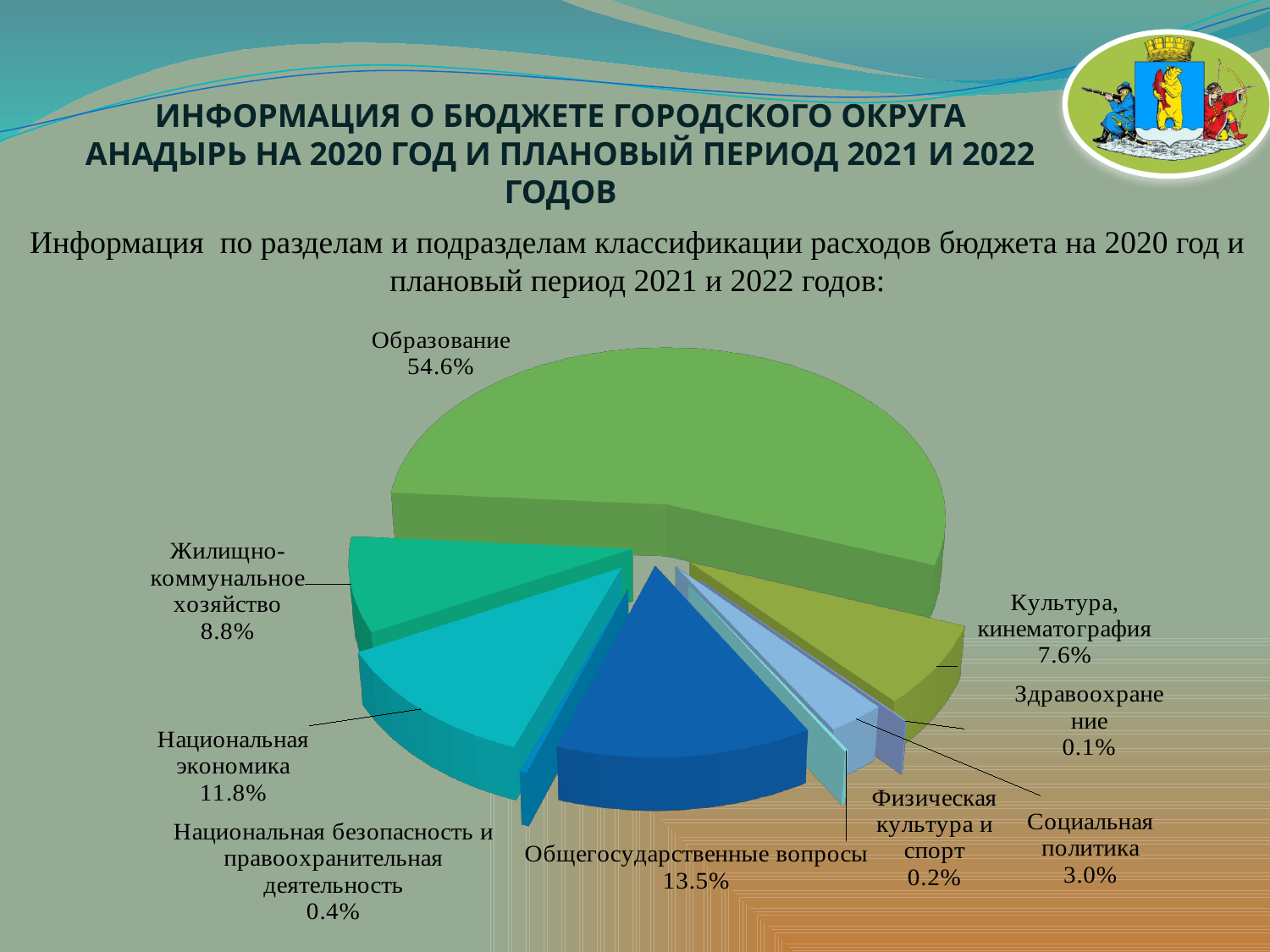
Which category has the smallest share of the pie? Здравоохранение What type of chart is shown on the slide? pie chart What share is shown for Социальная политика? 3.0% What share of the budget expenditure goes to Образование? 54.6% Which category has the largest share of the pie? Образование What is the value shown for Общегосударственные вопросы? 13.5% What is the difference between the shares of Общегосударственные вопросы and Национальная экономика? 1.7% What percentage is shown for Национальная экономика? 11.8% How many categories are shown in the pie chart? 9 What is the value shown for Физическая культура и спорт? 0.2% Which is larger: Жилищно-коммунальное хозяйство or Культура, кинематография? Жилищно-коммунальное хозяйство What is the value for Здравоохранение? 0.1%